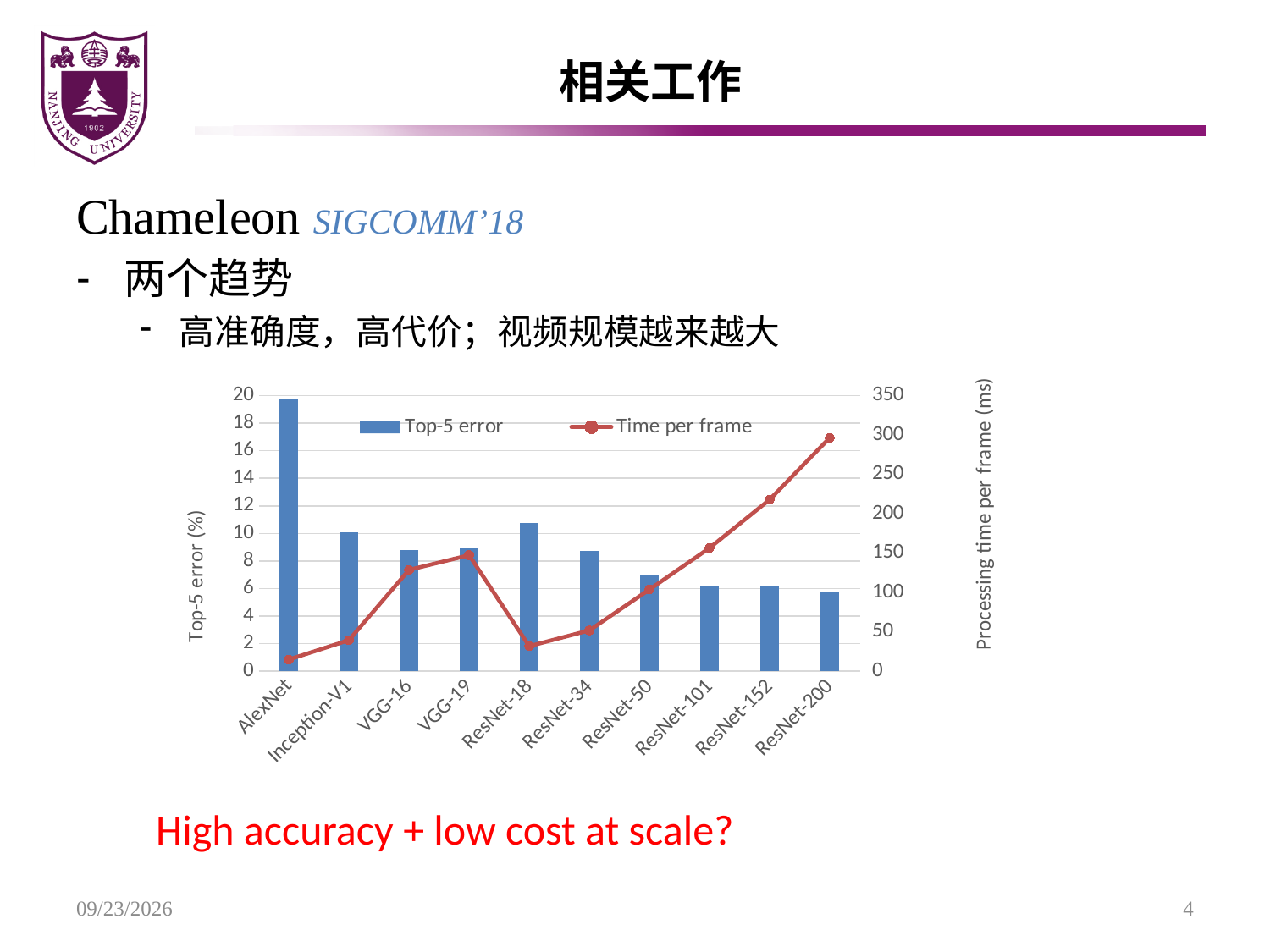
Does the Time per frame rise or fall from ResNet-18 to ResNet-200? rise Is the Time per frame for ResNet-200 greater or less than 250? greater Is the Time per frame for ResNet-18 greater or less than 50? less How many models (categories) are shown on the x axis of the chart? 10 Which model has the lowest Time per frame in the chart? AlexNet Which model has the highest Top-5 error in the chart? AlexNet Which has the larger Top-5 error, Inception-V1 or VGG-16? Inception-V1 Is the Top-5 error for AlexNet greater or less than 18? greater Which model has the highest Time per frame in the chart? ResNet-200 What are the two series named in the chart's legend? Top-5 error and Time per frame How many series does the chart's legend list? 2 What kind of chart is shown on the slide? Combined bar and line chart